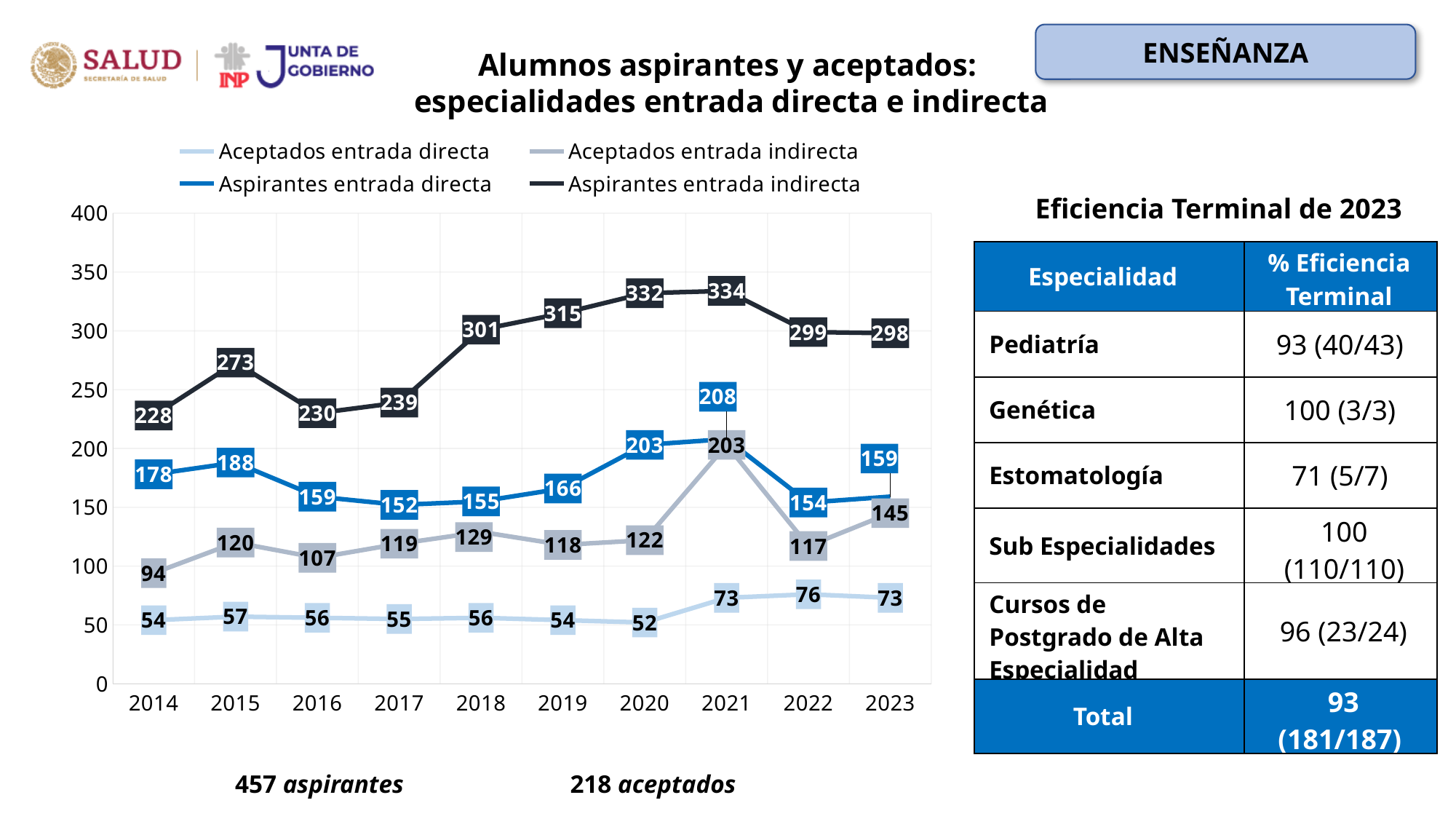
In which year is Aceptados entrada directa lowest? 2020 Which year has the larger value for Aceptados entrada indirecta, 2021 or 2022? 2021 In which year is Aspirantes entrada directa highest? 2021 How many series does the legend list? 4 What is the value for Aceptados entrada directa in 2022? 76 What is the value for Aceptados entrada indirecta in 2014? 94 How many years are shown on the x axis? 10 What is the difference between Aspirantes entrada indirecta and Aceptados entrada indirecta in 2023? 153 What kind of chart is shown? line chart Does Aspirantes entrada indirecta rise or fall from 2017 to 2021? rise What is the title of the chart? Alumnos aspirantes y aceptados: especialidades entrada directa e indirecta What is the value for Aspirantes entrada indirecta in 2021? 334